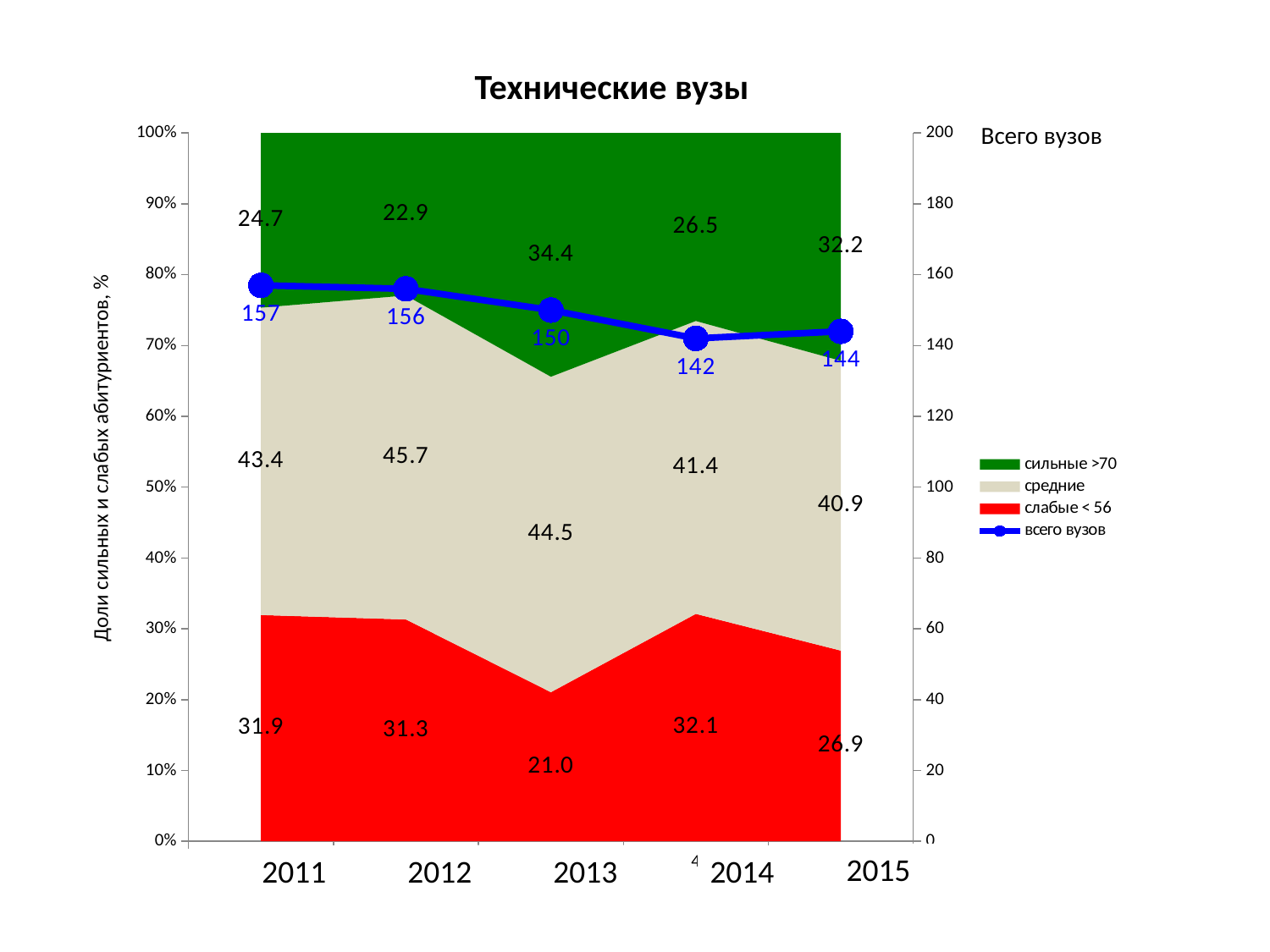
What is the value of 'средние' in 2012? 45.7 What is the title of the chart? Технические вузы How many years are shown on the x axis? 5 In which year is 'всего вузов' lowest? 2014 What is the value of 'слабые < 56' in 2013? 21.0 Does 'всего вузов' rise or fall from 2011 to 2014? fall In which year is 'сильные >70' highest? 2013 What is the value of 'всего вузов' in 2011? 157 What is the difference between 'всего вузов' in 2011 and in 2015? 13 What is the value of 'сильные >70' in 2015? 32.2 How many series does the legend list? 4 Which is larger: 'слабые < 56' in 2014 or in 2015? 2014